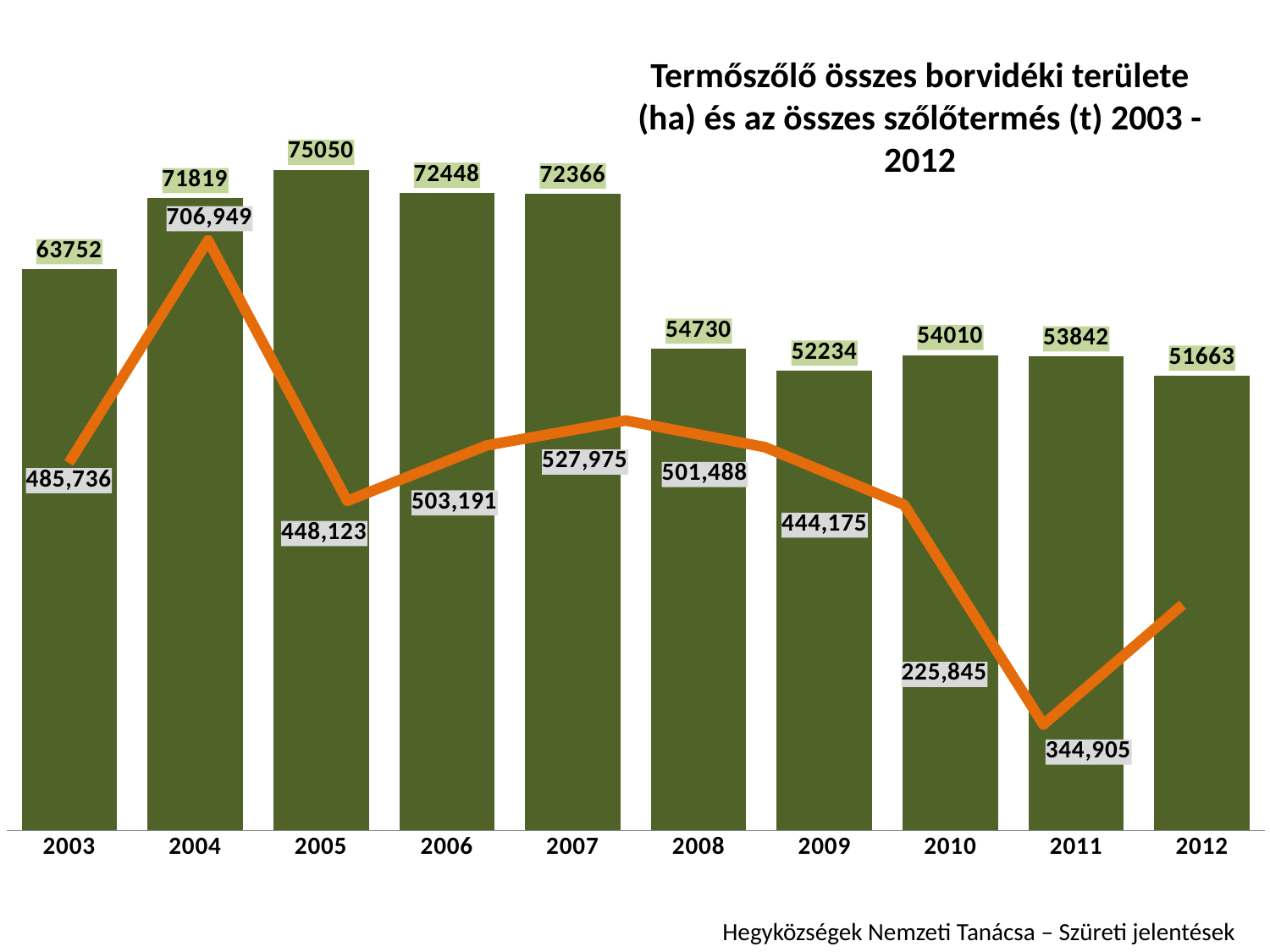
What is the value of the bar for 2005? 75050 Which year has the tallest bar? 2005 What is the value of the orange line at 2004? 706,949 What is the difference between the bar values for 2004 and 2003? 8067 How many years are shown on the x axis? 10 In which year does the orange line reach its highest point? 2004 What is the difference between the orange line values for 2004 and 2003? 221,213 What is the value of the bar for 2012? 51663 Which bar is taller, 2008 or 2010? 2008 Which year has the shortest bar? 2012 What kind of chart is this? A bar chart combined with a line chart Do the bar values rise or fall from 2005 to 2009? fall